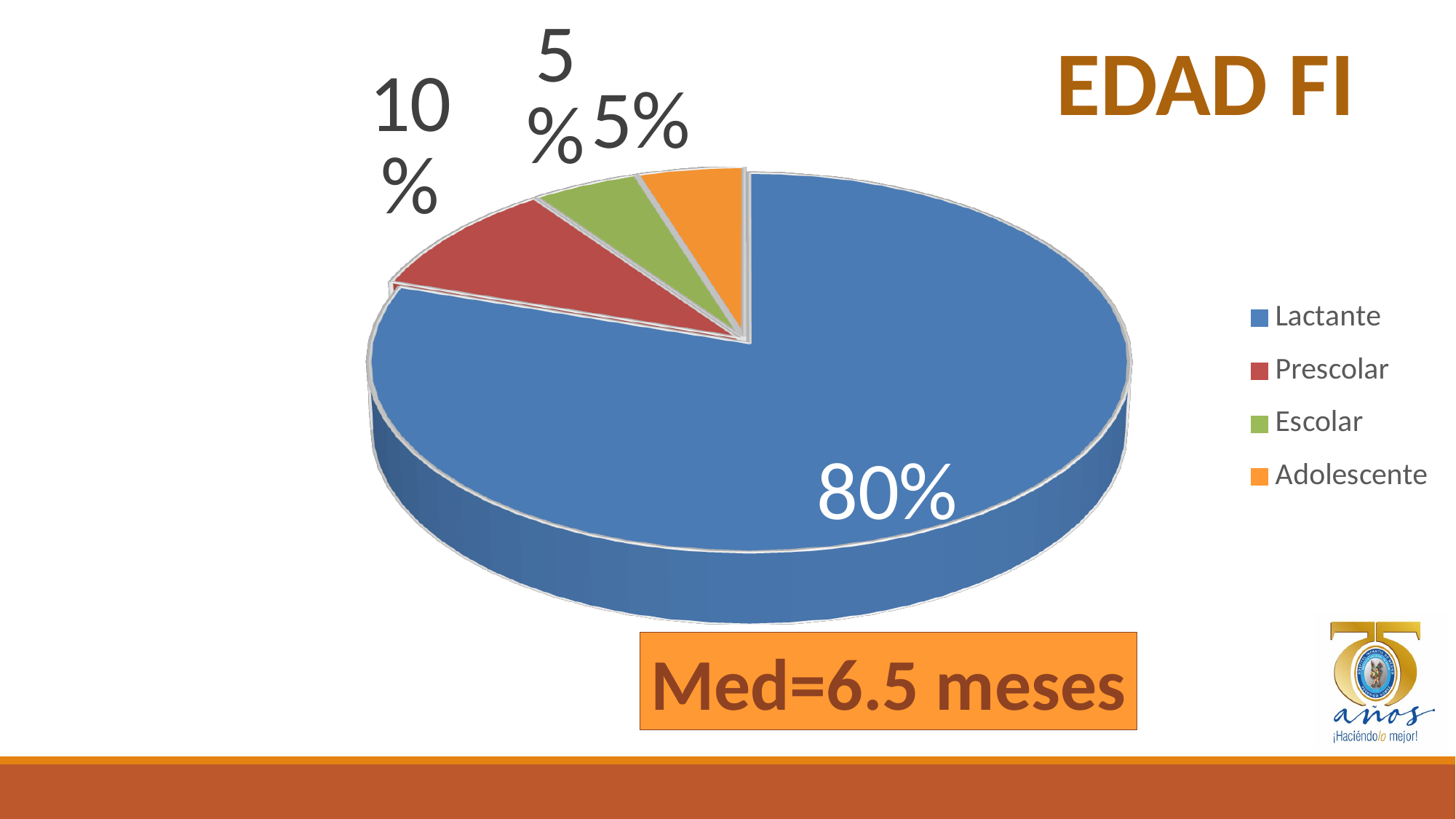
What is the difference in percentage points between the Lactante share and the Prescolar share? 70 What percentage of the pie does Prescolar represent? 10% How many categories does the legend list? 4 What percentage of the pie does Escolar represent? 5% What colour is the Lactante slice? Blue What percentage of the pie does Lactante represent? 80% What median value is stated below the chart? Med=6.5 meses What percentage of the pie does Adolescente represent? 5% What type of chart is shown on the slide? Pie chart Which category has the largest share of the pie? Lactante What is the title of the chart? EDAD FI Which is larger, the share for Lactante or the share for Prescolar? Lactante